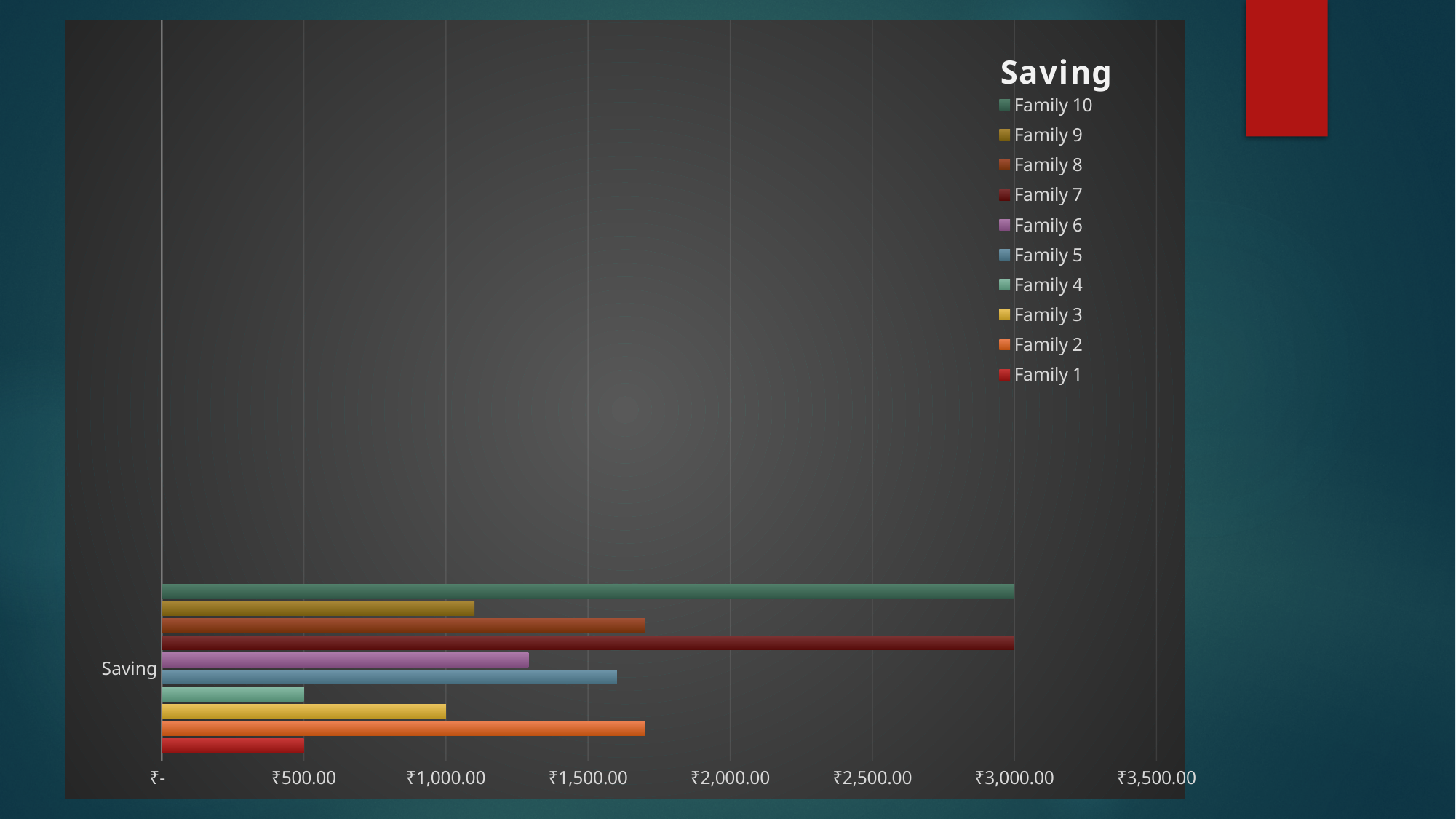
What is the difference between the Saving values for Family 10 and Family 4? ₹2,500.00 What is the Saving value for Family 3? ₹1,000.00 What is the Saving value for Family 1? ₹500.00 How many series does the legend list? 10 Is the Saving value for Family 6 greater or less than ₹1,500.00? less Is the Saving value for Family 8 greater or less than ₹1,500.00? greater How many categories are shown on the vertical axis? 1 What is the Saving value for Family 10? ₹3,000.00 Which has a larger Saving value, Family 5 or Family 6? Family 5 Which has a larger Saving value, Family 8 or Family 9? Family 8 What is the title of the chart? Saving What type of chart is shown on the slide? Bar chart